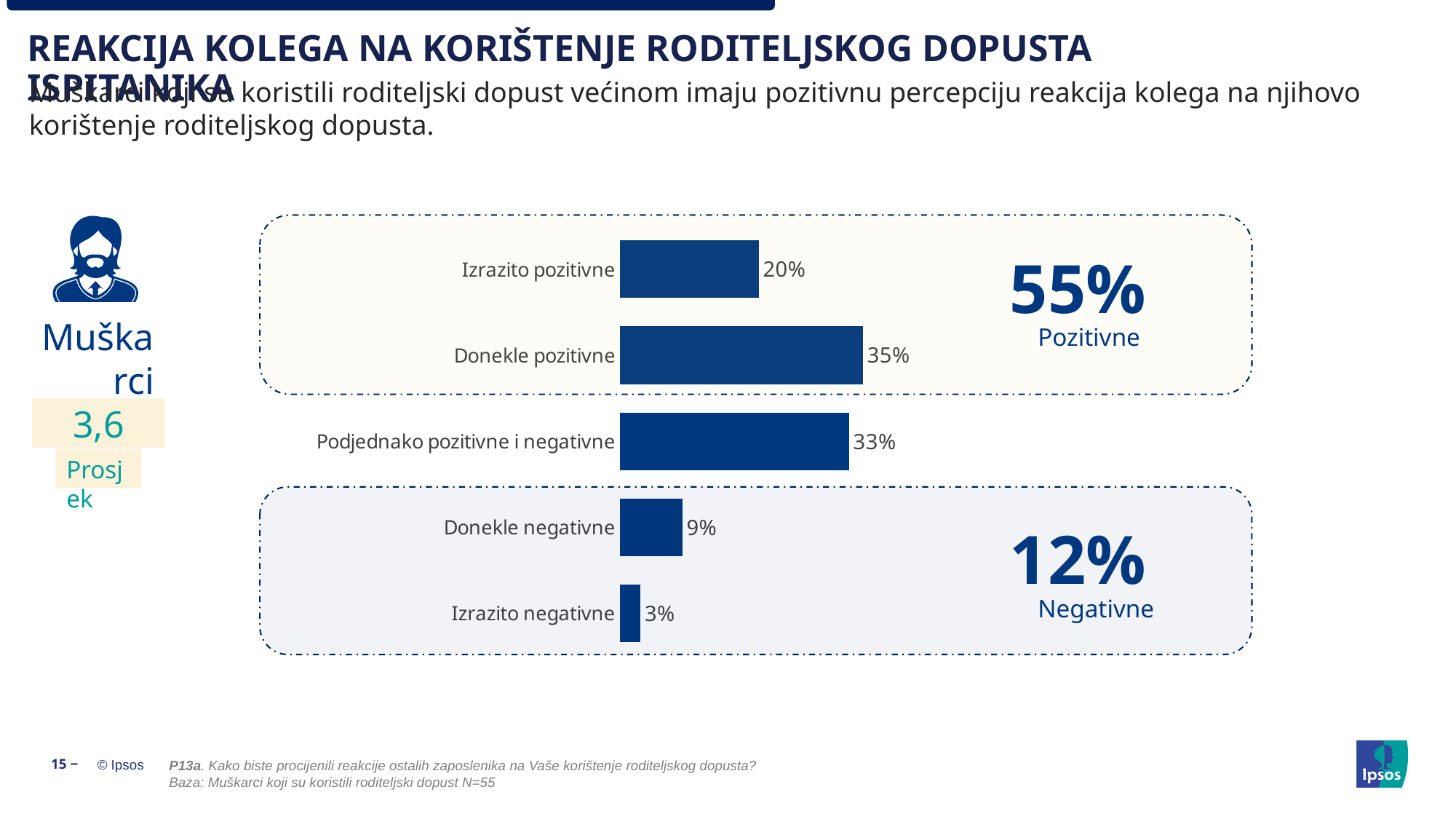
What is the value for "Podjednako pozitivne i negativne"? 33% What is the difference between the values for "Izrazito pozitivne" and "Donekle negativne"? 11% What is the value for "Donekle pozitivne"? 35% Which category has the lowest value? Izrazito negativne Which is larger, the value for "Izrazito pozitivne" or the value for "Podjednako pozitivne i negativne"? Podjednako pozitivne i negativne How many categories are shown in the chart? 5 What is the value for "Izrazito negativne"? 3% Which category has the highest value? Donekle pozitivne What kind of chart is shown on the slide? Bar chart What combined percentage is shown for the positive responses ("Pozitivne")? 55% What combined percentage is shown for the negative responses ("Negativne")? 12% What is the value for "Donekle negativne"? 9%